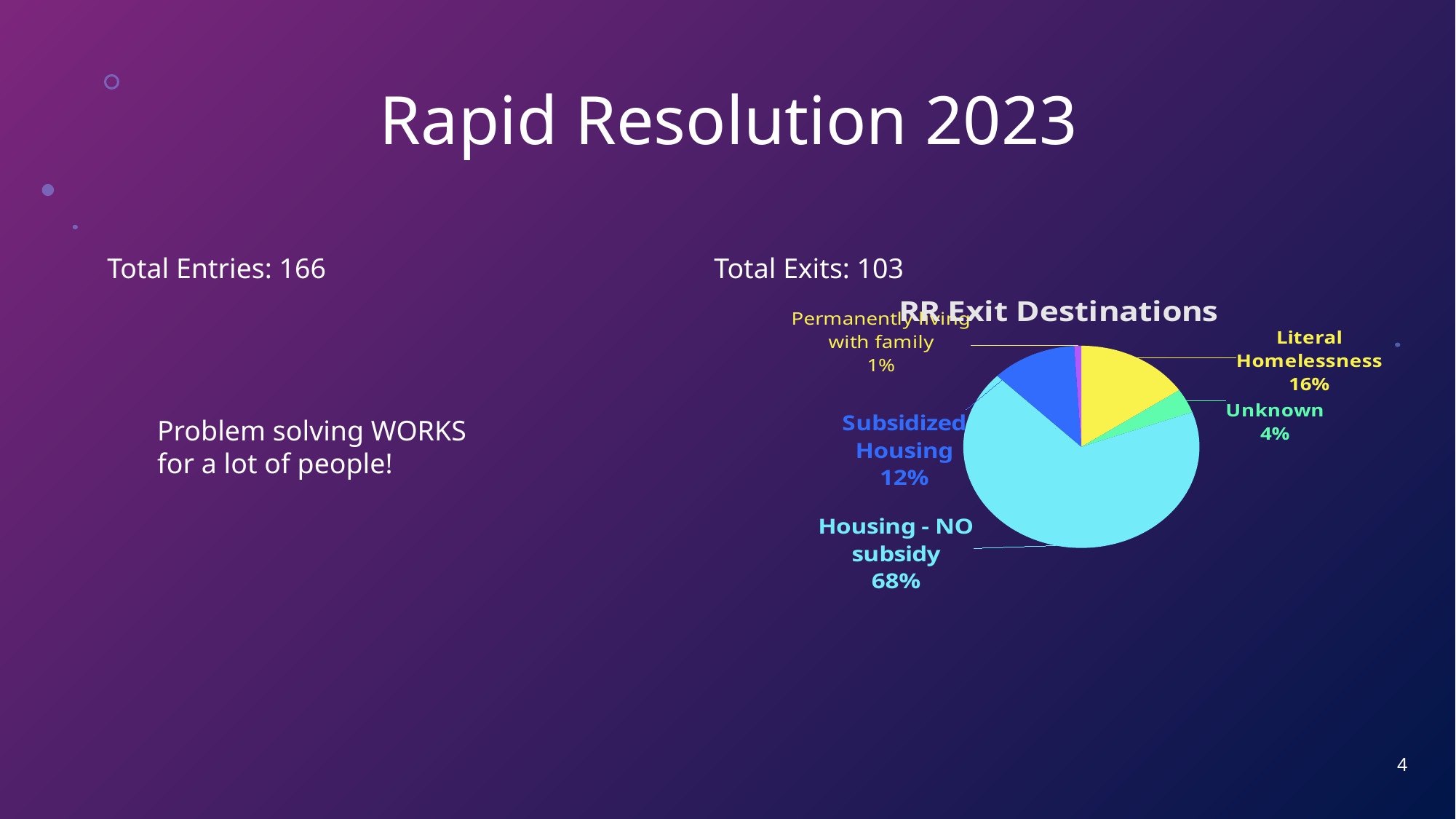
What share of exits went to Subsidized Housing? 12% What is the title of the chart? RR Exit Destinations Which exit destination has the largest share of the pie? Housing - NO subsidy What kind of chart is shown on the slide? pie chart What is the difference in percentage points between the Housing - NO subsidy share and the Literal Homelessness share? 52 percentage points What share of exits went to Housing - NO subsidy? 68% How many slices does the pie chart have? 5 Which exit destination has the smallest share of the pie? Permanently living with family What share of exits went to Literal Homelessness? 16% Which is larger, the share for Literal Homelessness or the share for Subsidized Housing? Literal Homelessness